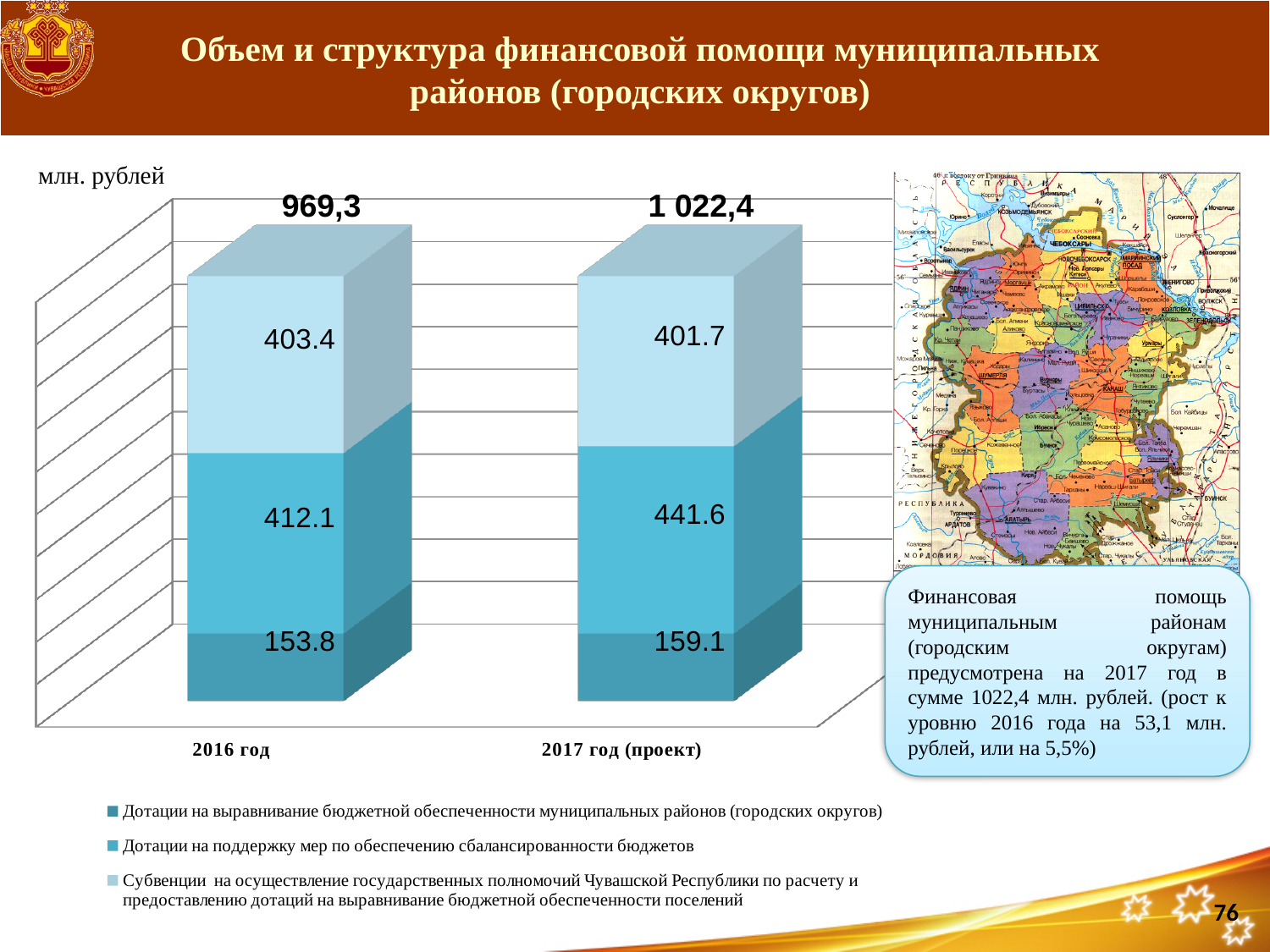
What is the total of the stacked bar for 2016 год? 969,3 What is the value of 'Дотации на выравнивание бюджетной обеспеченности муниципальных районов (городских округов)' for 2016 год? 153.8 Which category has the higher total, 2016 год or 2017 год (проект)? 2017 год (проект) What is the difference between the 'Дотации на поддержку мер по обеспечению сбалансированности бюджетов' values for 2017 год (проект) and 2016 год? 29.5 What is the value of 'Дотации на поддержку мер по обеспечению сбалансированности бюджетов' for 2017 год (проект)? 441.6 What is the value of 'Субвенции на осуществление государственных полномочий Чувашской Республики...' for 2016 год? 403.4 What unit is indicated above the chart? млн. рублей What type of chart is shown on the slide? stacked bar chart Does the value of 'Дотации на выравнивание бюджетной обеспеченности муниципальных районов (городских округов)' rise or fall from 2016 год to 2017 год (проект)? rise How many categories are shown on the x axis of the chart? 2 What is the total of the stacked bar for 2017 год (проект)? 1 022,4 How many series does the legend list? 3